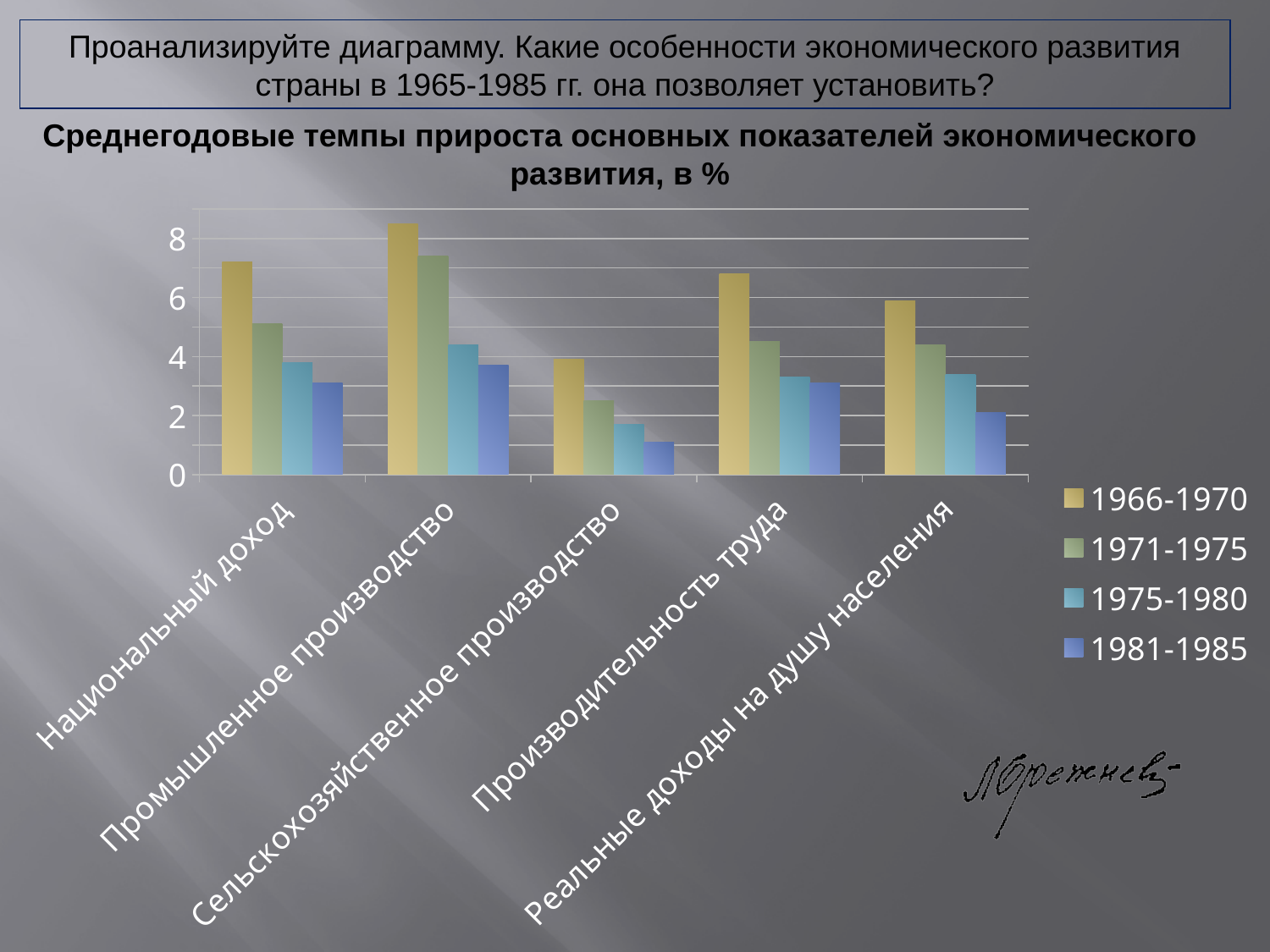
Is the value for Национальный доход in 1966-1970 greater or less than 6? greater Which category has the lowest value for the 1966-1970 series? Сельскохозяйственное производство What kind of chart is shown on the slide? bar chart Is the value for Промышленное производство in 1966-1970 greater or less than 8? greater Which category has the highest value for the 1966-1970 series? Промышленное производство What is the title of the chart? Среднегодовые темпы прироста основных показателей экономического развития, в % Is the value for Сельскохозяйственное производство in 1971-1975 greater or less than 4? less How many categories are shown on the x axis of the chart? 5 Which is larger for Реальные доходы на душу населения: the 1971-1975 value or the 1981-1985 value? 1971-1975 Which category has the lowest value for the 1981-1985 series? Сельскохозяйственное производство For Промышленное производство, do the values rise or fall from the 1966-1970 series to the 1981-1985 series? fall How many series does the legend list? 4